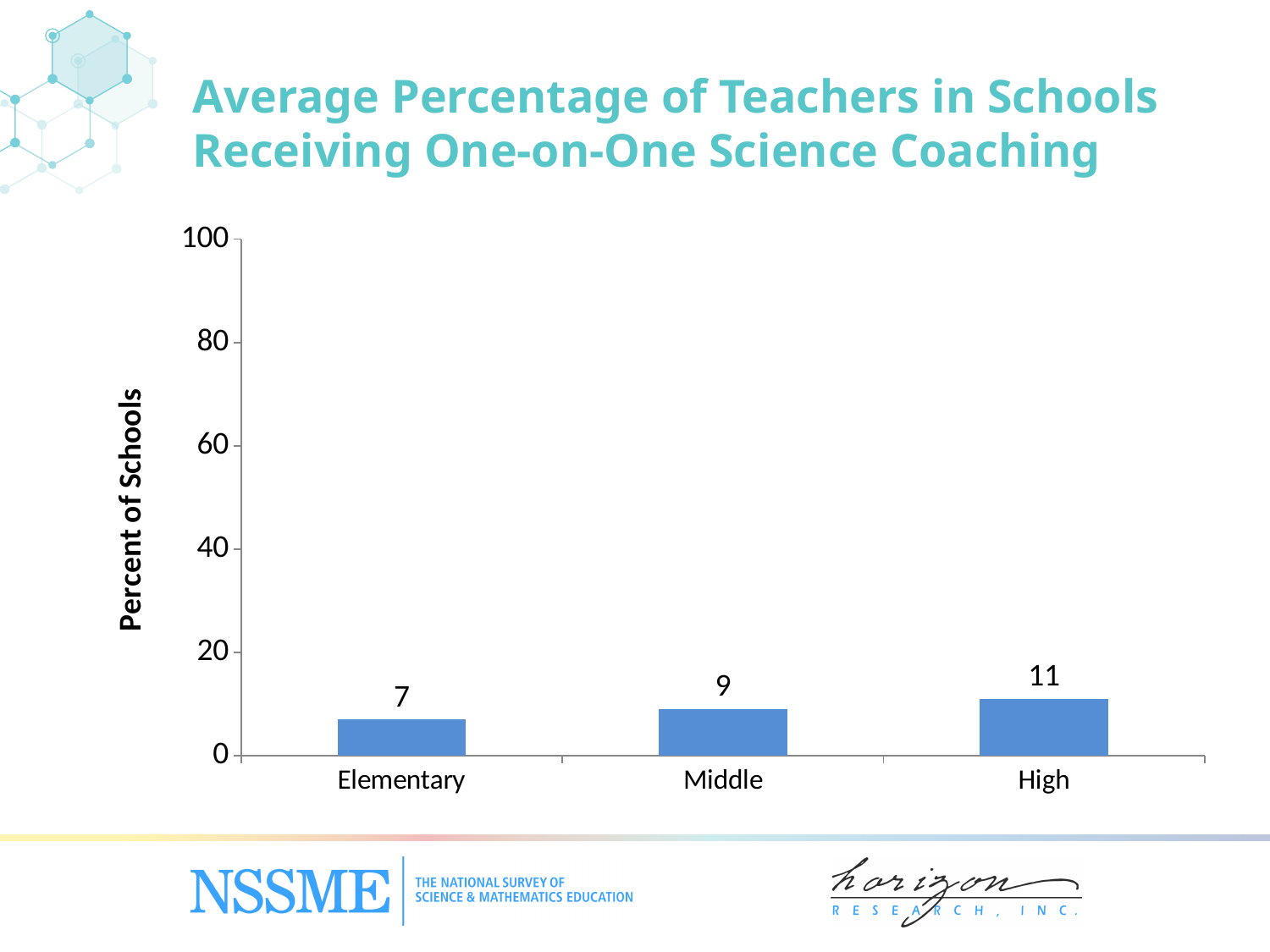
Do the values rise or fall from Elementary to High? rise Which category has the highest value? High What kind of chart is shown on the slide? bar chart Which category has the lowest value? Elementary What is the value for Middle? 9 What is the difference between the values for Middle and Elementary? 2 What is the difference between the values for High and Elementary? 4 What is the value for Elementary? 7 Which is larger, the value for Middle or the value for High? High How many categories are shown on the x axis? 3 Is the value for High greater or less than 20? less What is the value for High? 11